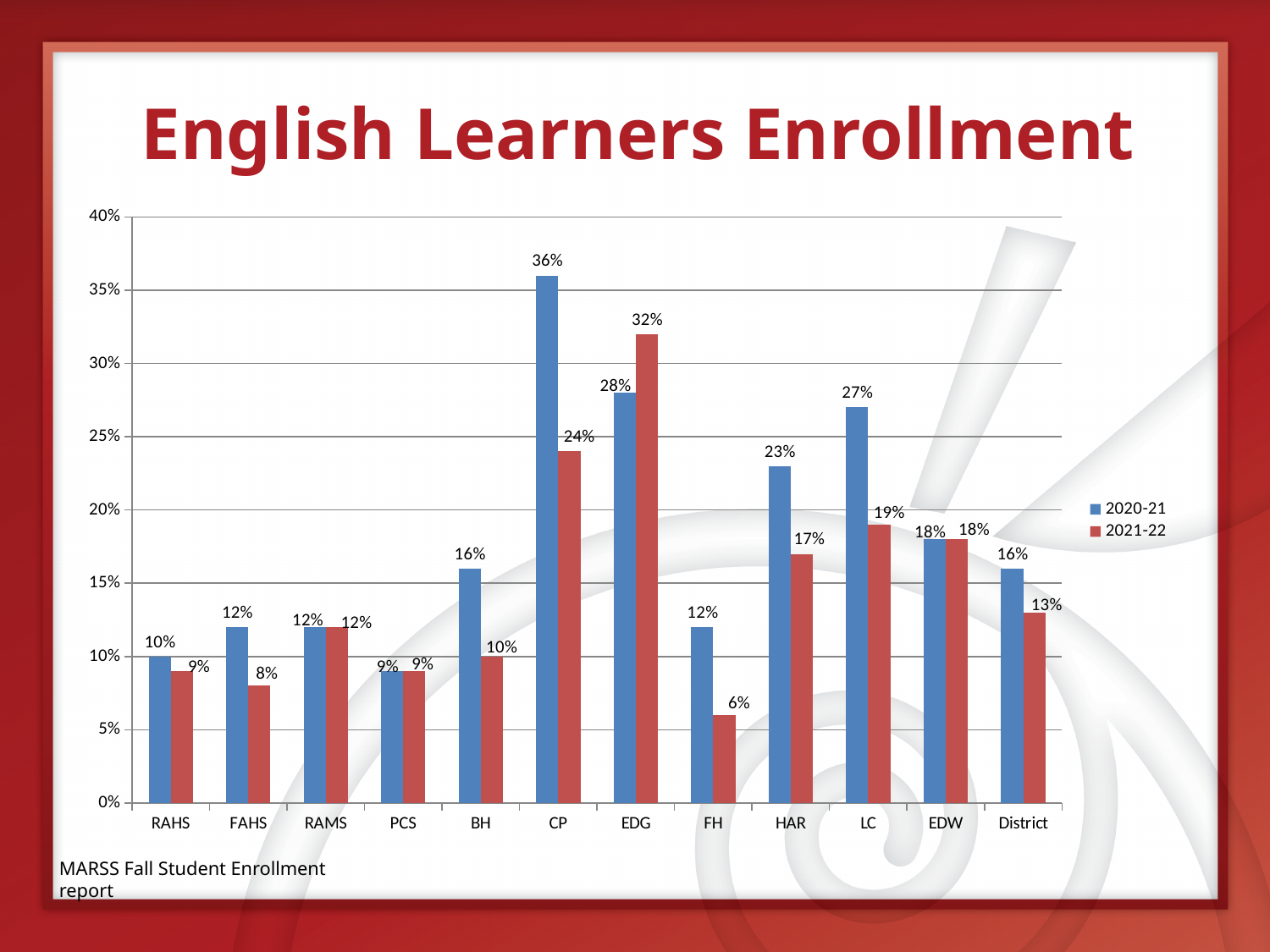
How many categories are shown on the x axis? 12 What is the 2021-22 value for FH? 6% What is the title of the chart? English Learners Enrollment Which category has the lowest 2021-22 value? FH What colour represents the 2021-22 series in the legend? Red What kind of chart is shown on the slide? Bar chart How many series does the legend list? 2 What is the 2020-21 value for CP? 36% Which category has the highest 2020-21 value? CP What is the difference between the 2020-21 and 2021-22 values for CP? 12% Which is larger for EDG: the 2020-21 value or the 2021-22 value? 2021-22 What is the 2021-22 value for District? 13%